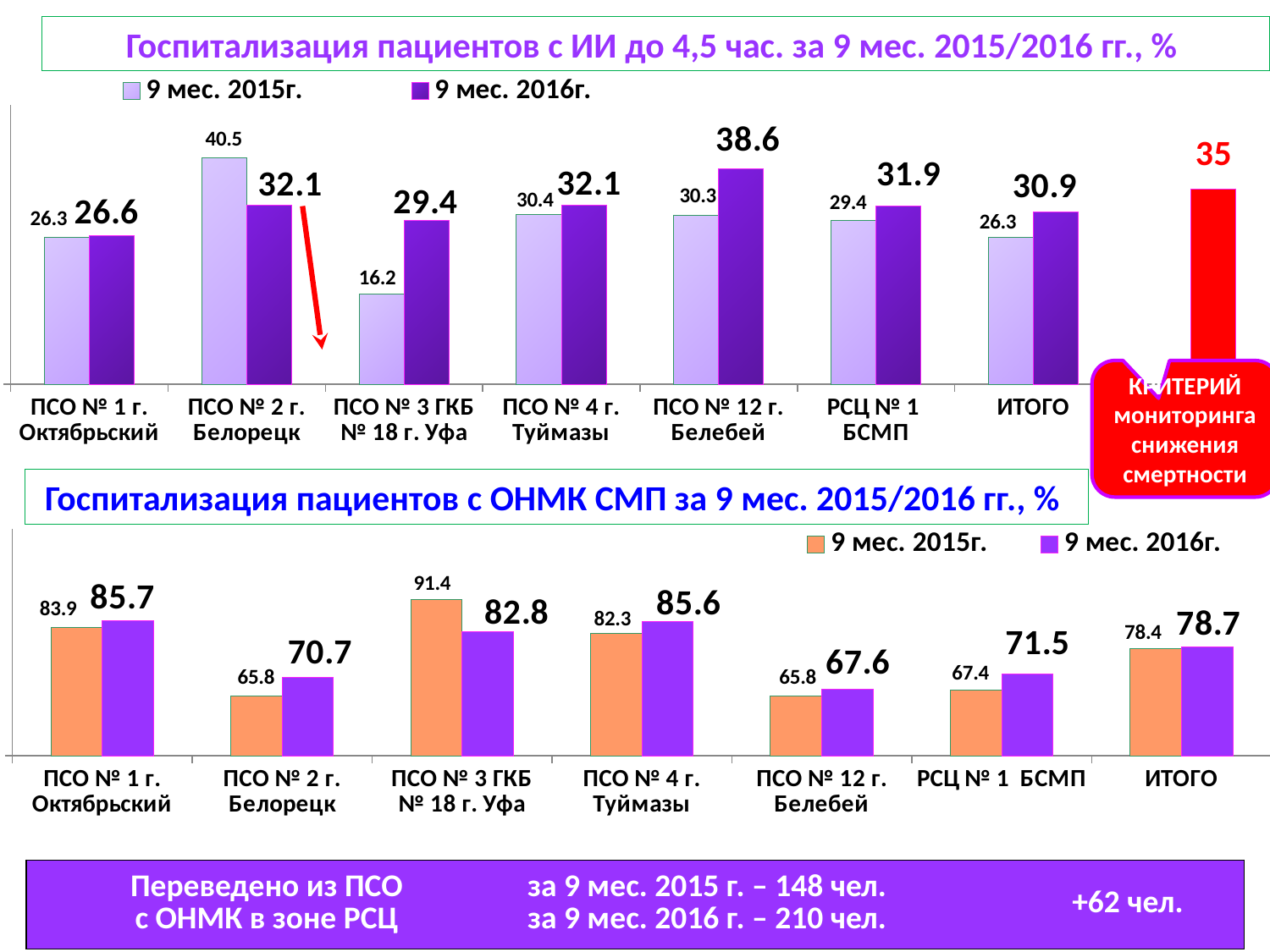
In the bottom chart (Госпитализация пациентов с ОНМК СМП), what is the value for ПСО № 3 ГКБ № 18 г. Уфа for 9 мес. 2015г.? 91.4 In the bottom chart (Госпитализация пациентов с ОНМК СМП), which category has the highest value for 9 мес. 2016г.? ПСО № 1 г. Октябрьский In the bottom chart (Госпитализация пациентов с ОНМК СМП), which is larger for ПСО № 3 ГКБ № 18 г. Уфа: the 9 мес. 2015г. value or the 9 мес. 2016г. value? 9 мес. 2015г. In the top chart (Госпитализация пациентов с ИИ до 4,5 час.), what value is shown for the red bar labelled Критерий мониторинга снижения смертности? 35 In the top chart (Госпитализация пациентов с ИИ до 4,5 час.), which category has the lowest value for 9 мес. 2015г.? ПСО № 3 ГКБ № 18 г. Уфа How many series does the legend of the bottom chart (Госпитализация пациентов с ОНМК СМП) list? 2 In the bottom chart (Госпитализация пациентов с ОНМК СМП), what is the ИТОГО value for 9 мес. 2016г.? 78.7 In the top chart (Госпитализация пациентов с ИИ до 4,5 час.), what is the difference between the 9 мес. 2016г. and 9 мес. 2015г. values for ПСО № 3 ГКБ № 18 г. Уфа? 13.2 In the top chart (Госпитализация пациентов с ИИ до 4,5 час.), which category has the highest value for 9 мес. 2016г.? ПСО № 12 г. Белебей In the top chart (Госпитализация пациентов с ИИ до 4,5 час.), what is the value for ПСО № 2 г. Белорецк for 9 мес. 2015г.? 40.5 In the bottom chart (Госпитализация пациентов с ОНМК СМП), what is the difference between the 9 мес. 2016г. and 9 мес. 2015г. values for ПСО № 2 г. Белорецк? 4.9 In the top chart (Госпитализация пациентов с ИИ до 4,5 час.), what is the value for ПСО № 12 г. Белебей for 9 мес. 2016г.? 38.6